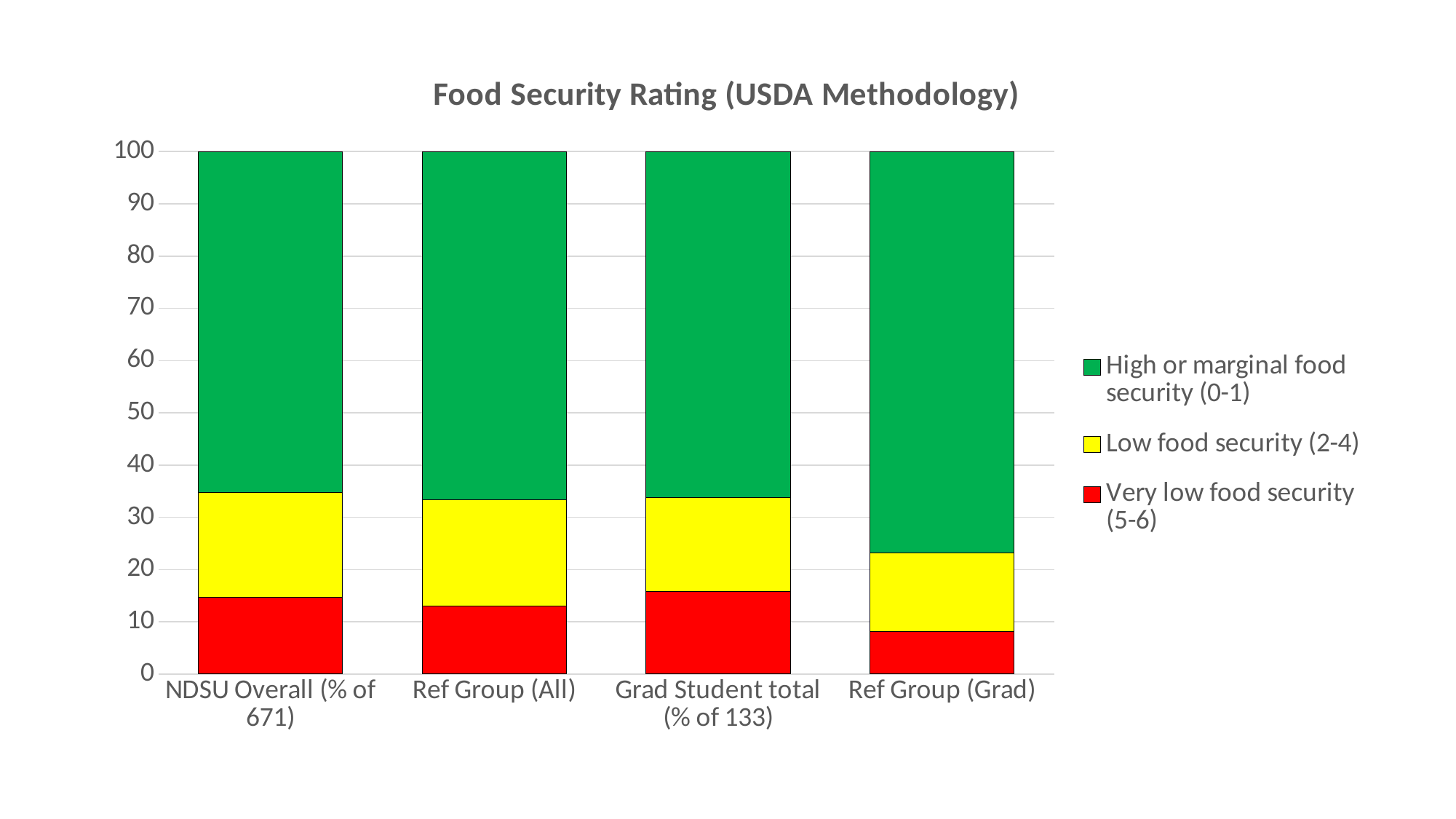
Which series is shown in red in the chart? Very low food security (5-6) Is the value for Very low food security (5-6) for Ref Group (Grad) greater or less than 10? less What is the total height of the stacked bar for Ref Group (All)? 100 How many categories are shown on the x axis of the chart? 4 Which is larger, the High or marginal food security (0-1) segment for Ref Group (Grad) or for Ref Group (All)? Ref Group (Grad) What type of chart is shown on the slide? Stacked bar chart Which category has the lowest value for Very low food security (5-6)? Ref Group (Grad) Which is larger, the Very low food security (5-6) value for NDSU Overall (% of 671) or for Ref Group (Grad)? NDSU Overall (% of 671) Is the value for Very low food security (5-6) for NDSU Overall (% of 671) greater or less than 10? greater What is the title of the chart? Food Security Rating (USDA Methodology) Is the value for Very low food security (5-6) for Grad Student total (% of 133) greater or less than 10? greater How many series does the legend list? 3